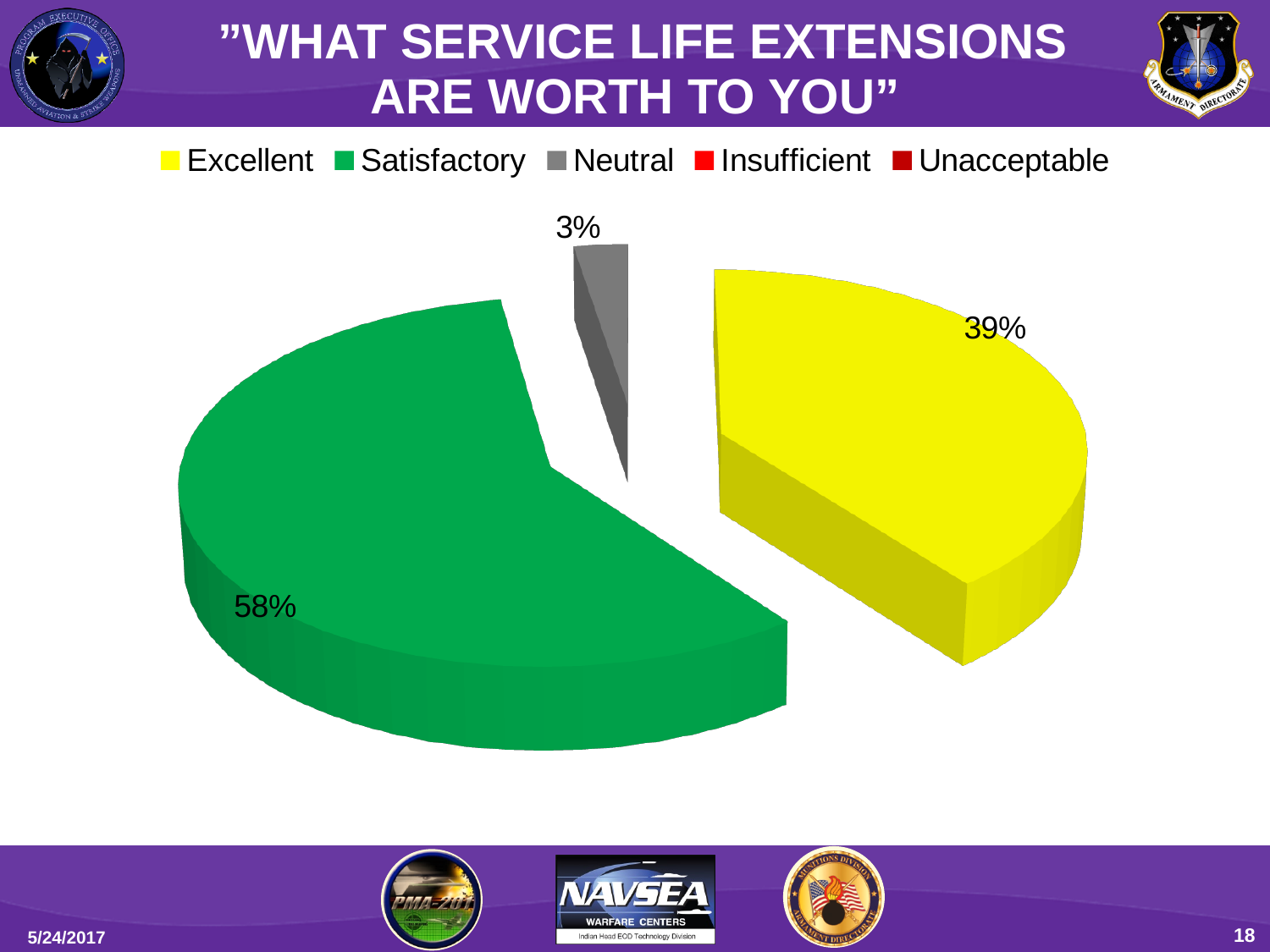
What is the title of the slide containing the chart? "What Service Life Extensions Are Worth To You" What percentage of the pie is labelled for the Satisfactory slice? 58% Which slice is larger, Excellent or Neutral? Excellent What kind of chart is shown on the slide? Pie chart What is the difference in percentage points between the Satisfactory and Excellent slices? 19 What colour represents the Excellent category in the legend? Yellow How many slices of the pie are labelled with a percentage? 3 What percentage is shown for the Excellent slice? 39% How many entries does the legend list? 5 Which of the labelled slices is the smallest? Neutral Which category has the largest slice of the pie? Satisfactory What percentage is shown for the Neutral slice? 3%